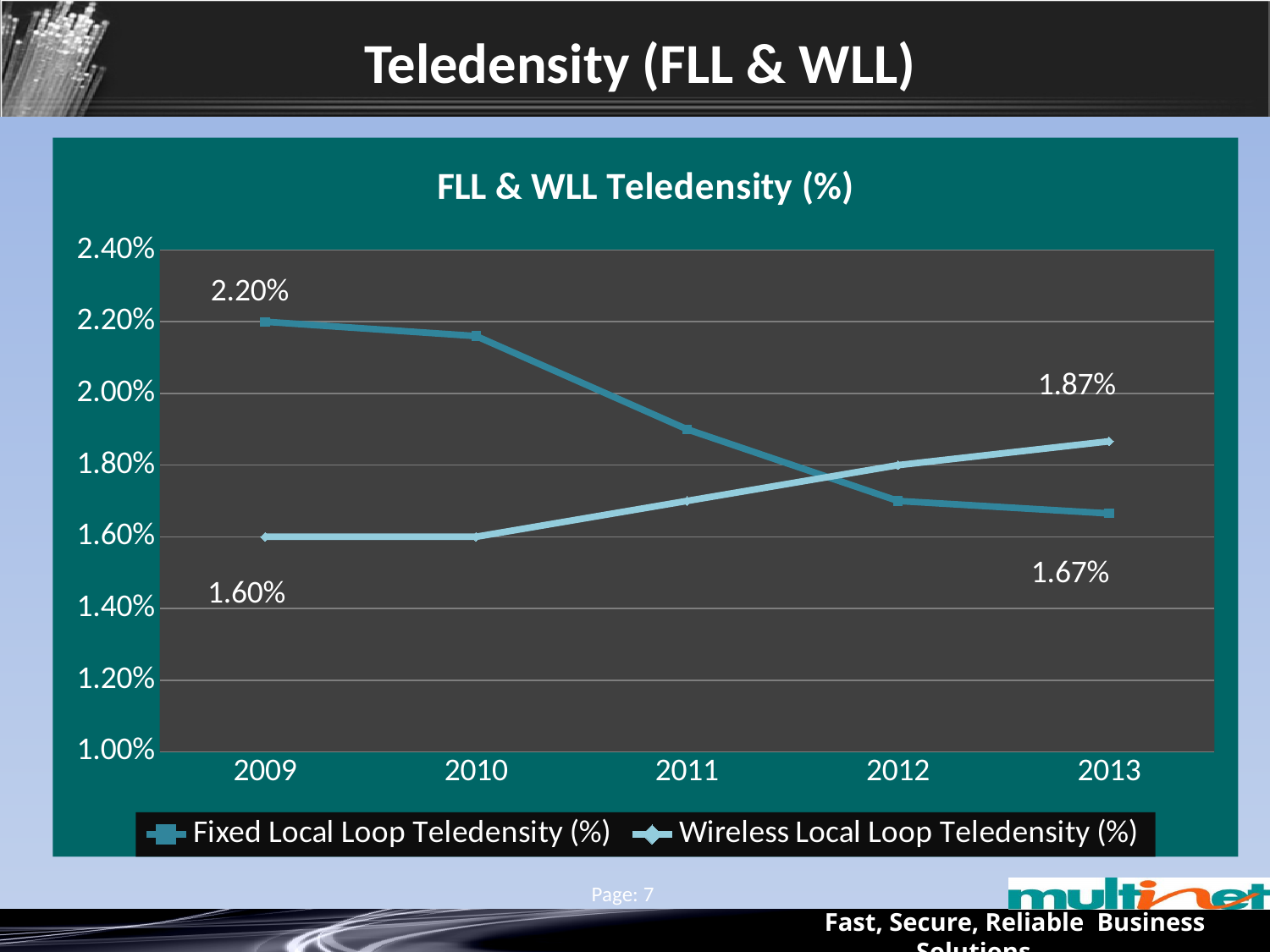
By how much did Fixed Local Loop Teledensity (%) fall from 2009 to 2013? 0.53% In 2013, which series has the higher value, Fixed Local Loop Teledensity (%) or Wireless Local Loop Teledensity (%)? Wireless Local Loop Teledensity (%) What is the difference between Wireless Local Loop Teledensity (%) and Fixed Local Loop Teledensity (%) in 2013? 0.20% What is the Fixed Local Loop Teledensity (%) value in 2009? 2.20% What is the Fixed Local Loop Teledensity (%) value in 2013? 1.67% Does Wireless Local Loop Teledensity (%) rise or fall from 2009 to 2013? rise Does Fixed Local Loop Teledensity (%) rise or fall from 2009 to 2013? fall What is the Wireless Local Loop Teledensity (%) value in 2009? 1.60% What is the Wireless Local Loop Teledensity (%) value in 2013? 1.87% Is the Fixed Local Loop Teledensity (%) value in 2011 greater or less than 1.80%? greater How many years are shown on the x axis of the chart? 5 What kind of chart is shown on the slide? line chart